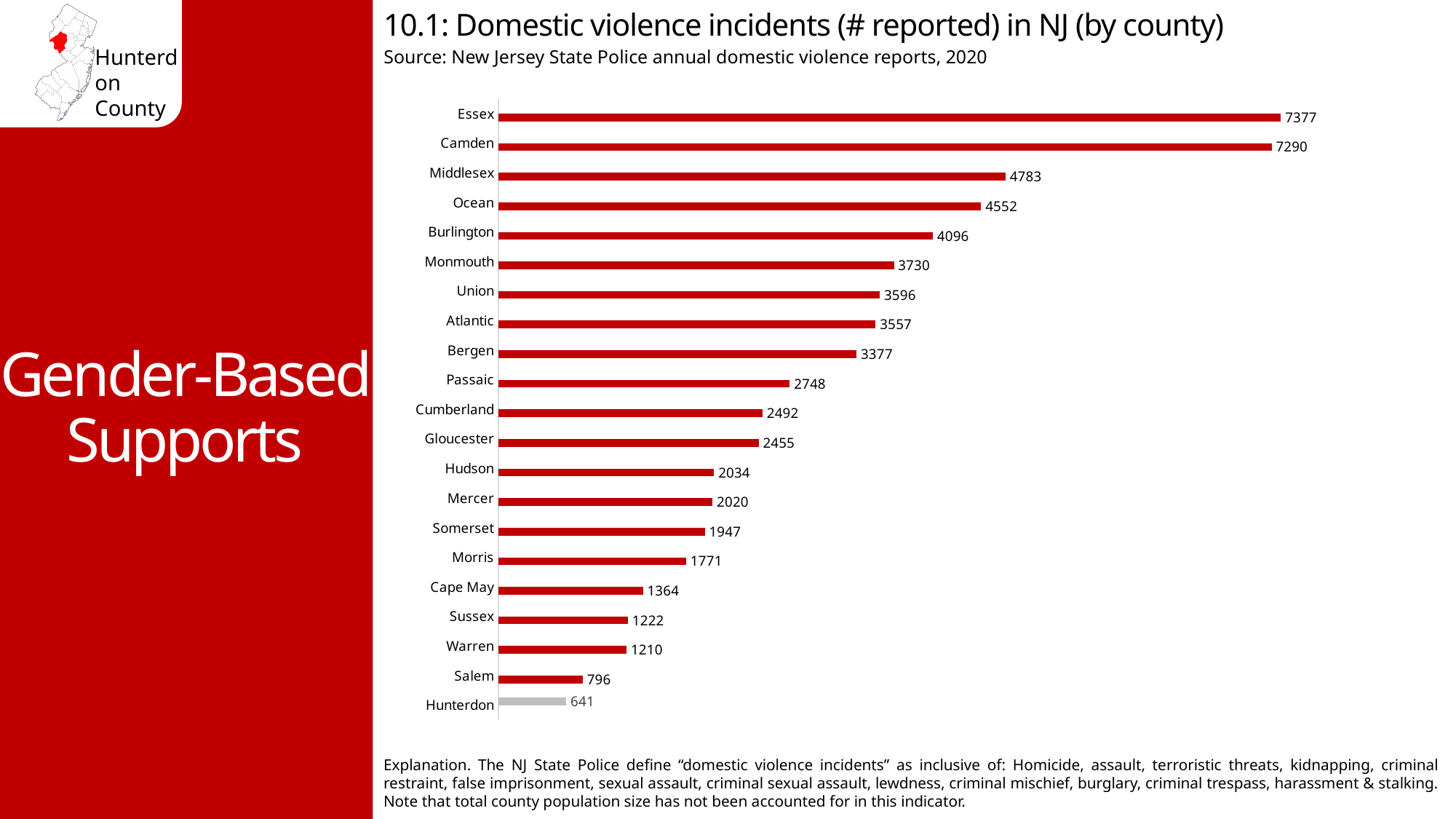
What is the number of reported domestic violence incidents for Cape May County? 1364 What is the difference between the values for Essex and Camden? 87 Which county has the lowest number of reported domestic violence incidents? Hunterdon Which county has the highest number of reported domestic violence incidents? Essex What is the number of reported domestic violence incidents for Middlesex County? 4783 Which county's bar is shown in grey rather than red? Hunterdon What kind of chart is used to show domestic violence incidents by county? Bar chart Which county has more reported incidents, Ocean or Burlington? Ocean Which county has more reported incidents, Morris or Somerset? Somerset What is the number of reported domestic violence incidents for Hunterdon County? 641 What is the difference between the values for Salem and Hunterdon? 155 How many counties are shown in the chart? 21